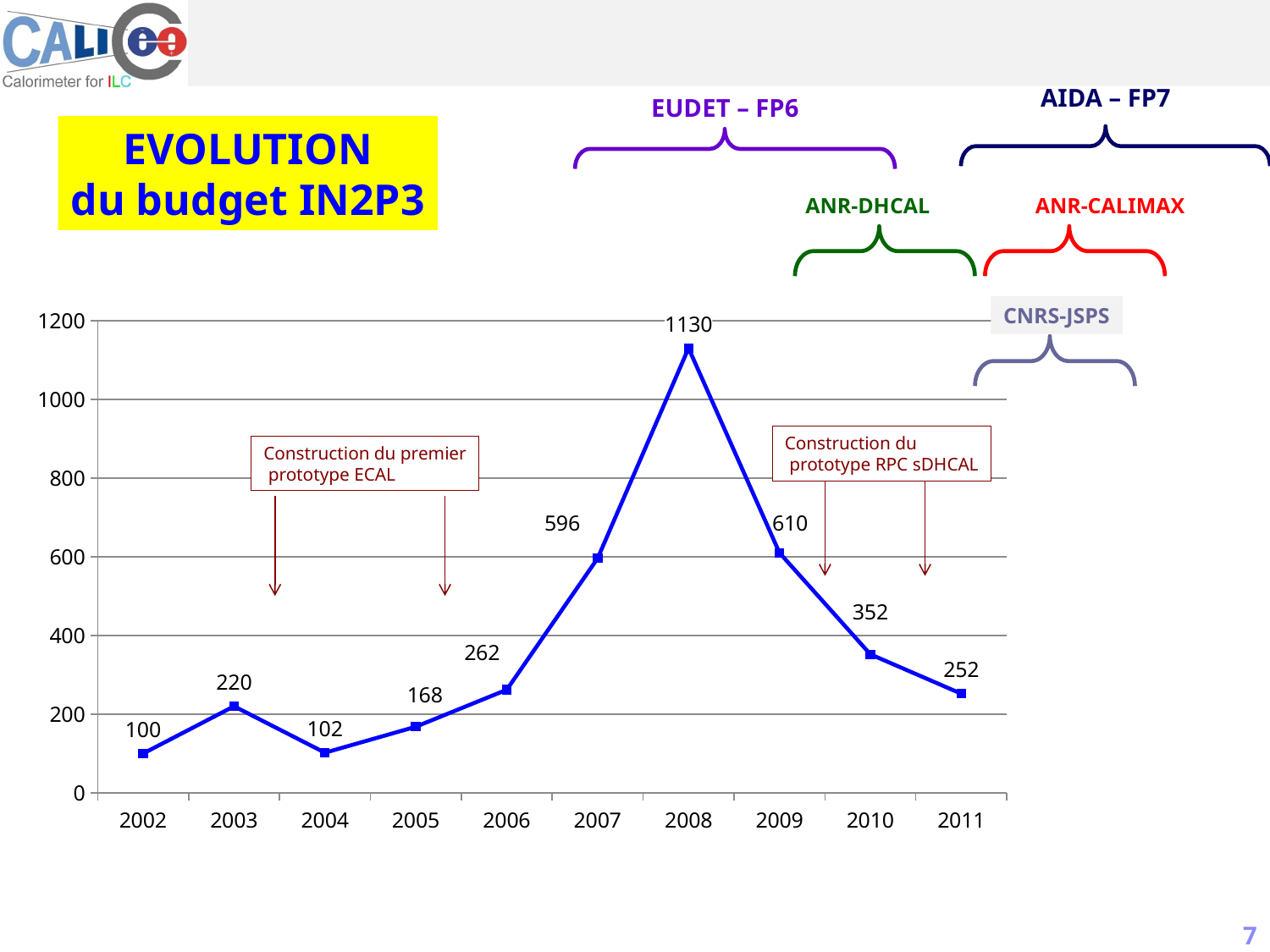
Which year has the lowest value on the chart? 2002 What is the value plotted for 2005? 168 What is the difference between the values for 2008 and 2009? 520 What is the difference between the values for 2010 and 2011? 100 Is the value for 2007 greater or less than 400? greater Which is larger, the value for 2003 or the value for 2004? 2003 What is the value plotted for 2011? 252 Do the values rise or fall from 2008 to 2011? fall What kind of chart is shown on the slide? line chart How many years are plotted on the x axis? 10 Which year has the highest value on the chart? 2008 What is the IN2P3 budget value shown for 2008? 1130